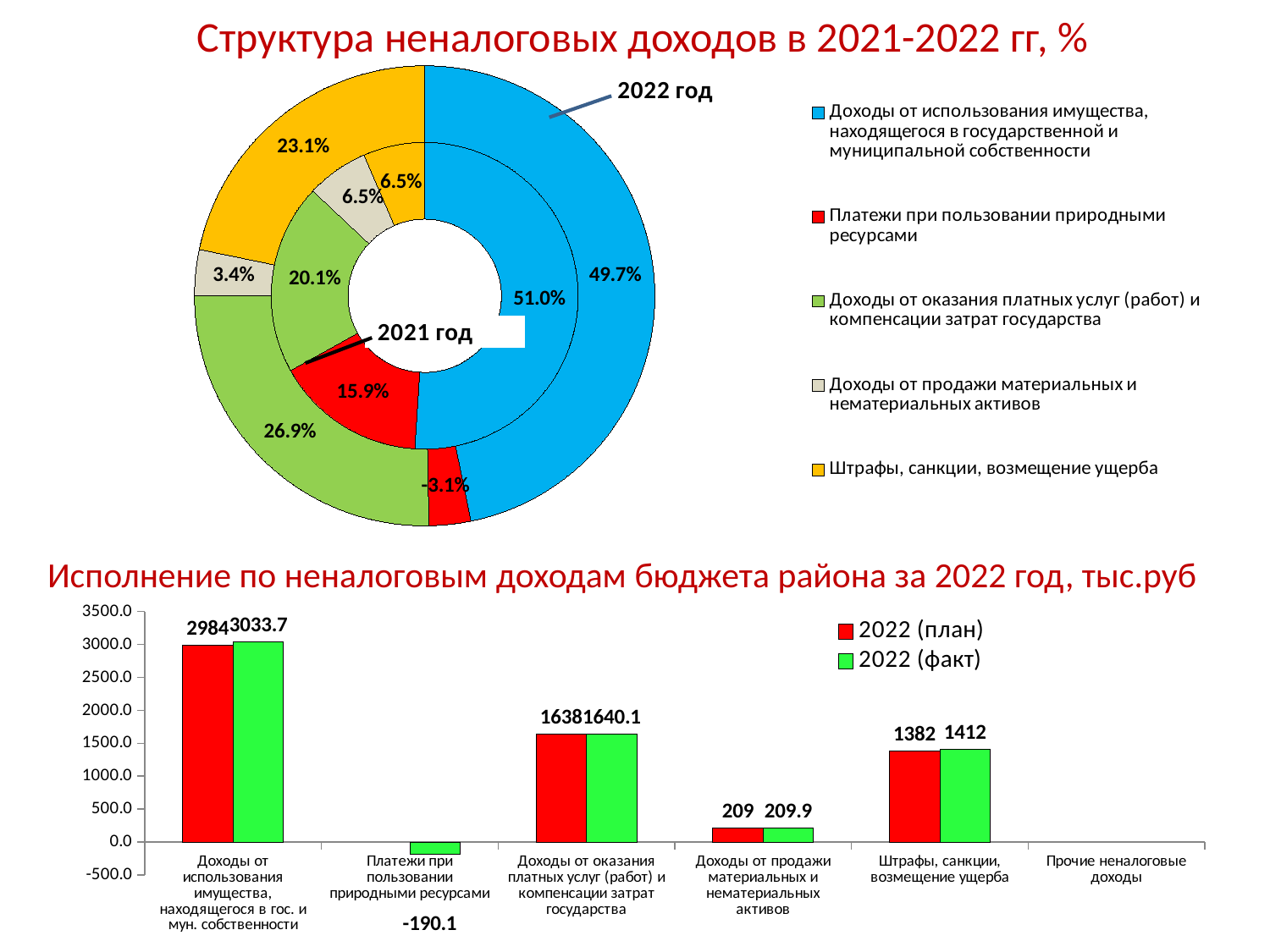
What kind of chart is the bottom chart titled 'Исполнение по неналоговым доходам бюджета района за 2022 год, тыс.руб'? bar chart In the top doughnut chart, by how many percentage points did the share of 'Штрафы, санкции, возмещение ущерба' change from 2021 (6.5%) to 2022 (23.1%)? 16.6 In the top doughnut chart, what is the 2021 share for 'Штрафы, санкции, возмещение ущерба'? 6.5% What kind of chart is the top chart titled 'Структура неналоговых доходов в 2021-2022 гг, %'? doughnut chart In the top doughnut chart, what is the 2022 share for 'Платежи при пользовании природными ресурсами'? -3.1% In the bottom bar chart, what is the 2022 (план) value for 'Штрафы, санкции, возмещение ущерба'? 1382 In the bottom bar chart, what is the difference between the 2022 (факт) and 2022 (план) values for 'Штрафы, санкции, возмещение ущерба'? 30 In the top doughnut chart, which category has the largest share in 2021? Доходы от использования имущества, находящегося в государственной и муниципальной собственности In the top doughnut chart, what is the 2022 share for 'Доходы от использования имущества, находящегося в государственной и муниципальной собственности'? 49.7% In the top doughnut chart, how many categories does the legend list? 5 In the bottom bar chart, how many series does the legend list? 2 In the bottom bar chart, what is the 2022 (факт) value for 'Доходы от использования имущества, находящегося в гос. и мун. собственности'? 3033.7